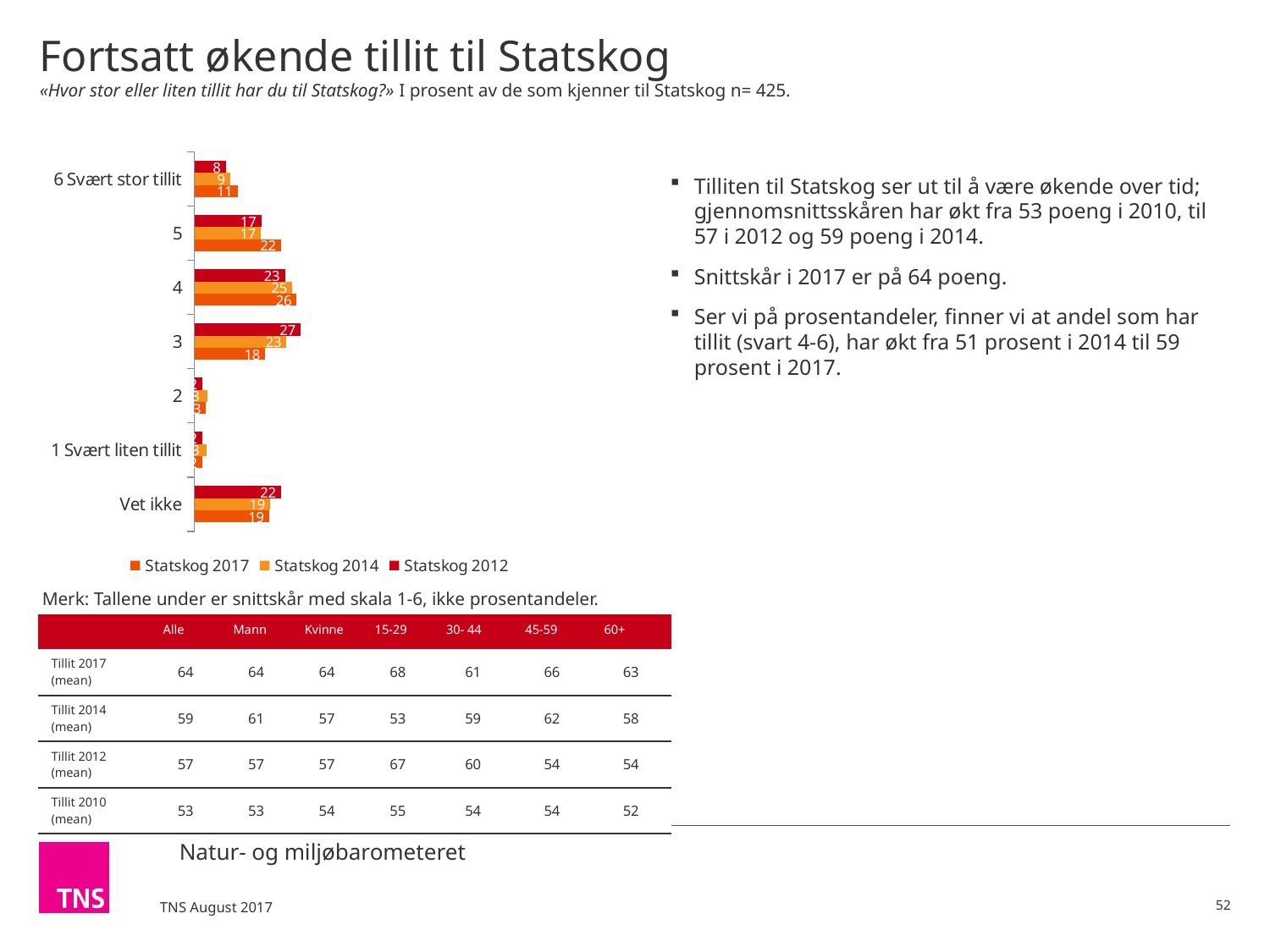
What kind of chart is shown on the slide? bar chart How many series does the chart legend list? 3 How many categories are shown on the chart's vertical axis? 7 What is the value for Statskog 2012 in the category 'Vet ikke'? 22 What is the difference between the Statskog 2017 and Statskog 2012 values in the category '5'? 5 What is the value for Statskog 2014 in the category '4'? 25 In the category '3', which is larger: the Statskog 2012 value or the Statskog 2017 value? Statskog 2012 Which category has the highest value for Statskog 2017? 4 Which series is shown in red in the chart legend? Statskog 2012 What is the value for Statskog 2012 in the category '3'? 27 Which category has the highest value for Statskog 2012? 3 What is the value for Statskog 2017 in the category '6 Svært stor tillit'? 11